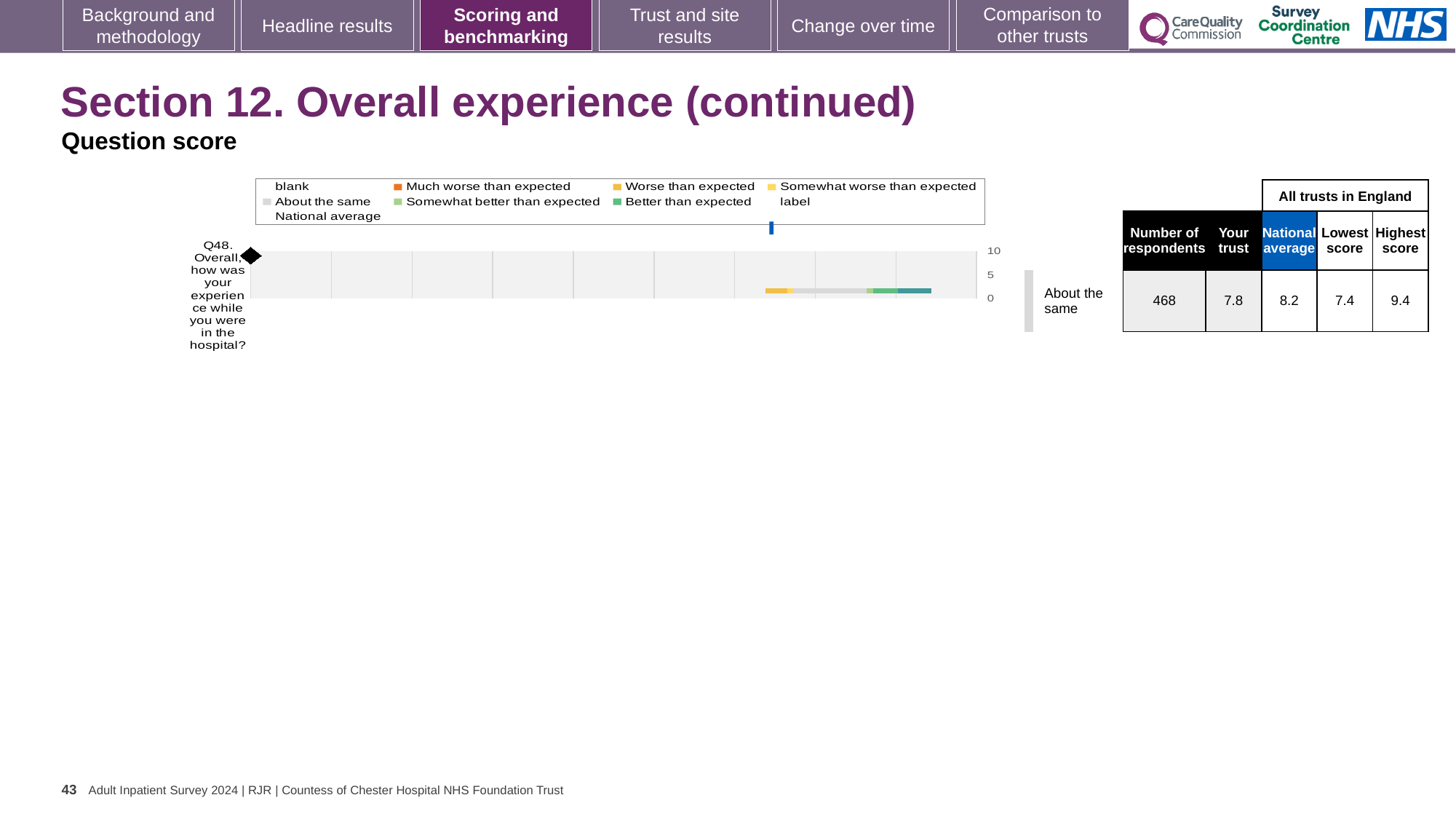
What is the difference between the national average and the 'Your trust' score for Q48? 0.4 What is the lowest score among all trusts in England for Q48? 7.4 What is the highest score among all trusts in England for Q48? 9.4 What is the national average score for Q48? 8.2 Which is larger for Q48, the 'Your trust' score or the national average? National average What is the difference between the highest score and the lowest score for Q48? 2.0 What is the highest value shown on the chart's numeric axis? 10 What kind of chart is shown for Q48 on the slide? bar chart How many questions (categories) are plotted in the chart? 1 What is the number of respondents for Q48? 468 Which question is plotted in the chart? Q48. Overall, how was your experience while you were in the hospital? What is the 'Your trust' score for Q48? 7.8